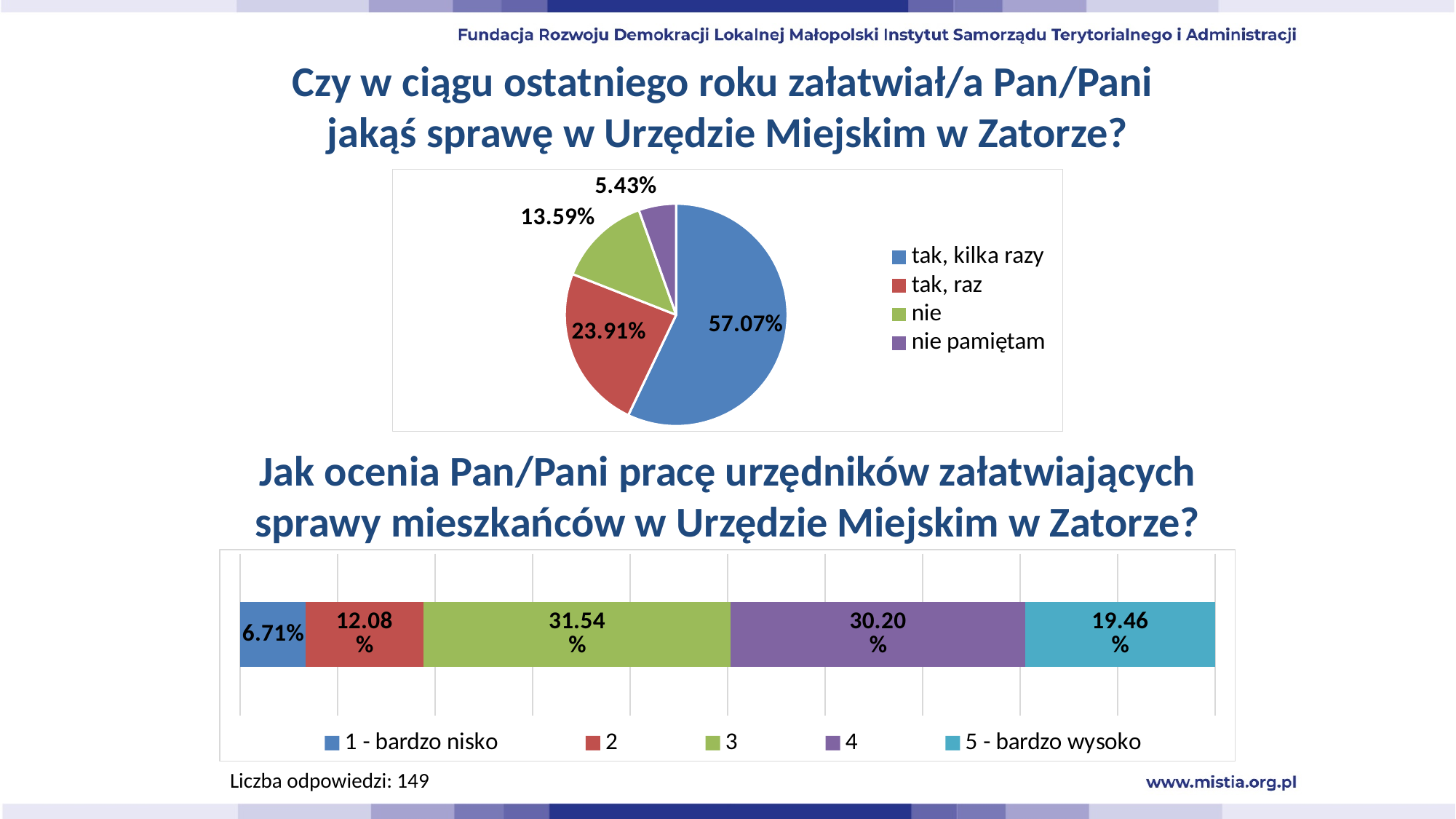
In the top pie chart, which category has the largest slice? tak, kilka razy What type of chart is the bottom chart on the slide? Stacked bar chart In the bottom bar chart, which rating has the smallest share? 1 - bardzo nisko In the bottom bar chart, what percentage is shown for rating "3"? 31.54% In the top pie chart, what is the difference between the shares for "tak, kilka razy" and "tak, raz"? 33.16% In the bottom bar chart, what percentage is shown for "5 - bardzo wysoko"? 19.46% In the bottom bar chart, which is larger: the share for rating "3" or rating "4"? 3 In the top pie chart, what share of respondents answered "tak, kilka razy"? 57.07% How many series does the legend of the bottom bar chart list? 5 In the top pie chart, what percentage is shown for "nie pamiętam"? 5.43% How many categories does the legend of the top pie chart list? 4 In the top pie chart, which category has the smallest slice? nie pamiętam